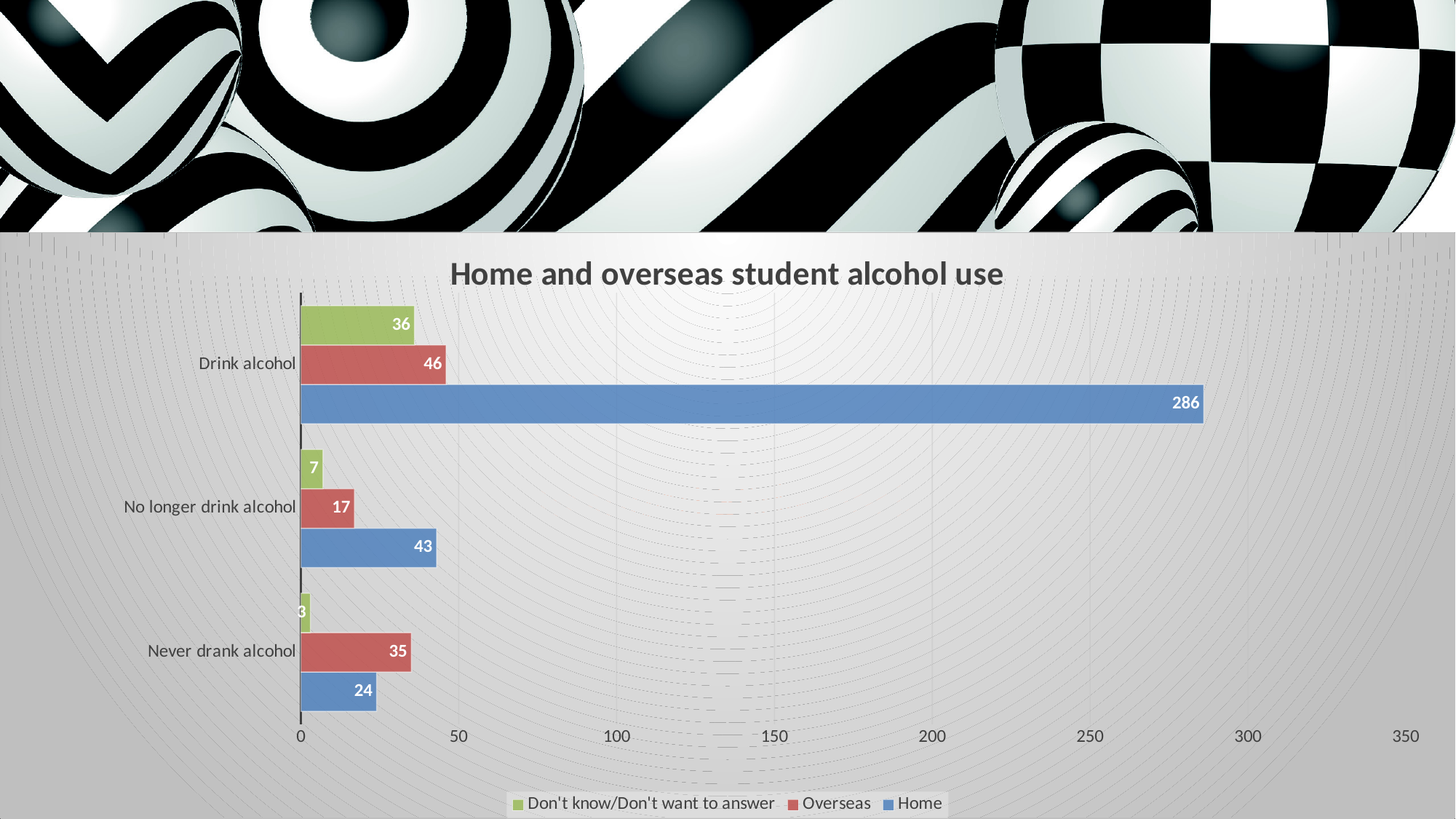
Is the Home value for Drink alcohol greater or less than 250? greater What is the Home value for Drink alcohol? 286 Which category has the lowest Overseas value? No longer drink alcohol How many categories are shown on the chart? 3 What is the title of the chart? Home and overseas student alcohol use How many series does the legend list? 3 For Never drank alcohol, which is larger: the Overseas value or the Home value? Overseas Which category has the highest Home value? Drink alcohol What is the Overseas value for Never drank alcohol? 35 What kind of chart is shown on the slide? Bar chart What is the difference between the Home and Overseas values for Drink alcohol? 240 What is the Don't know/Don't want to answer value for No longer drink alcohol? 7